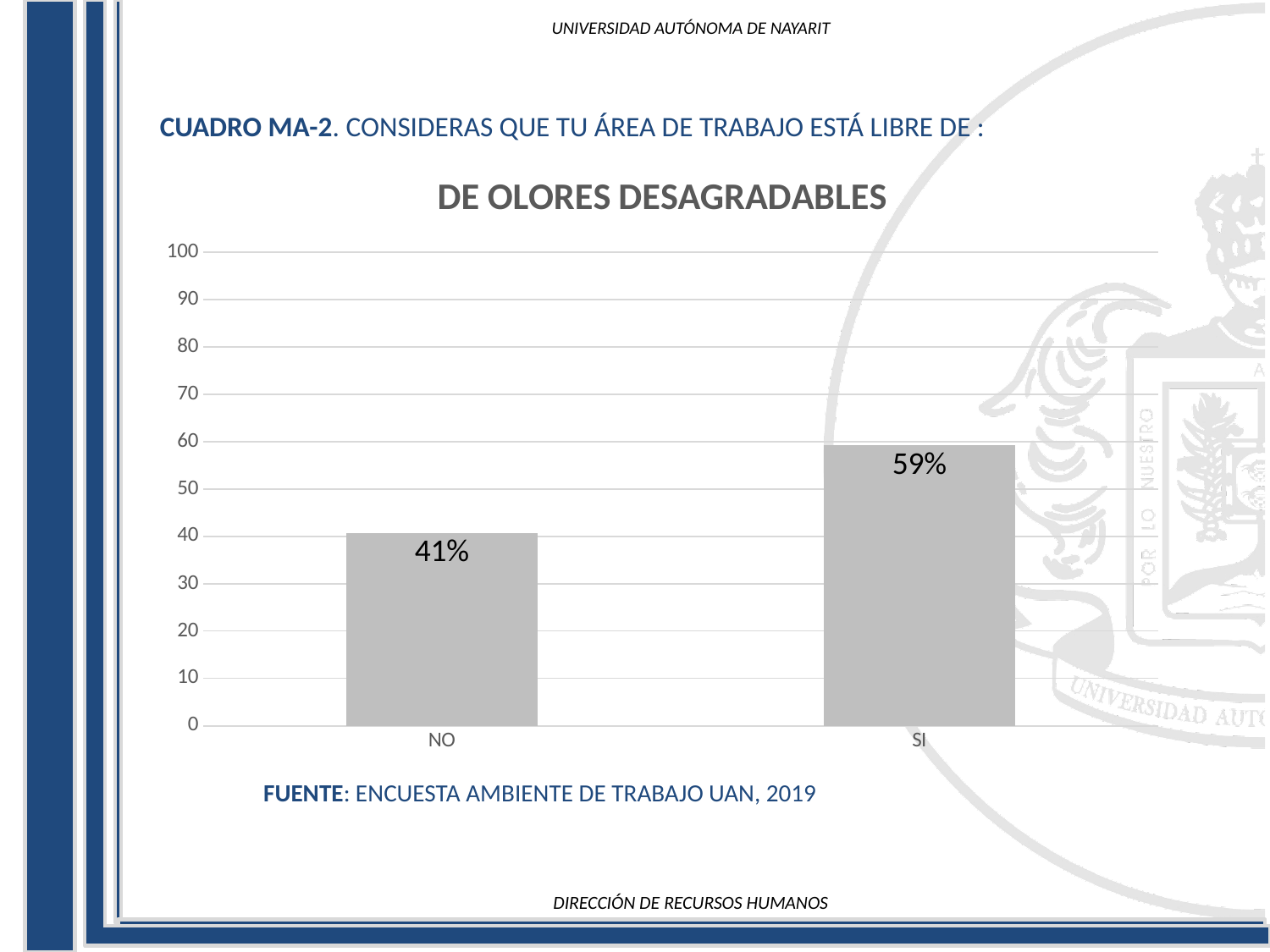
What kind of chart is shown on the slide? bar chart Which is larger, the value for NO or the value for SI? SI How many categories are shown on the x axis? 2 What is the value for NO? 41% What is the value for SI? 59% Is the value for NO greater or less than 50? less What is the difference between the values for SI and NO? 18% Which category has the highest value? SI Which category has the lowest value? NO What is the maximum value shown on the y axis? 100 What is the title of the chart? DE OLORES DESAGRADABLES Is the value for SI greater or less than 50? greater